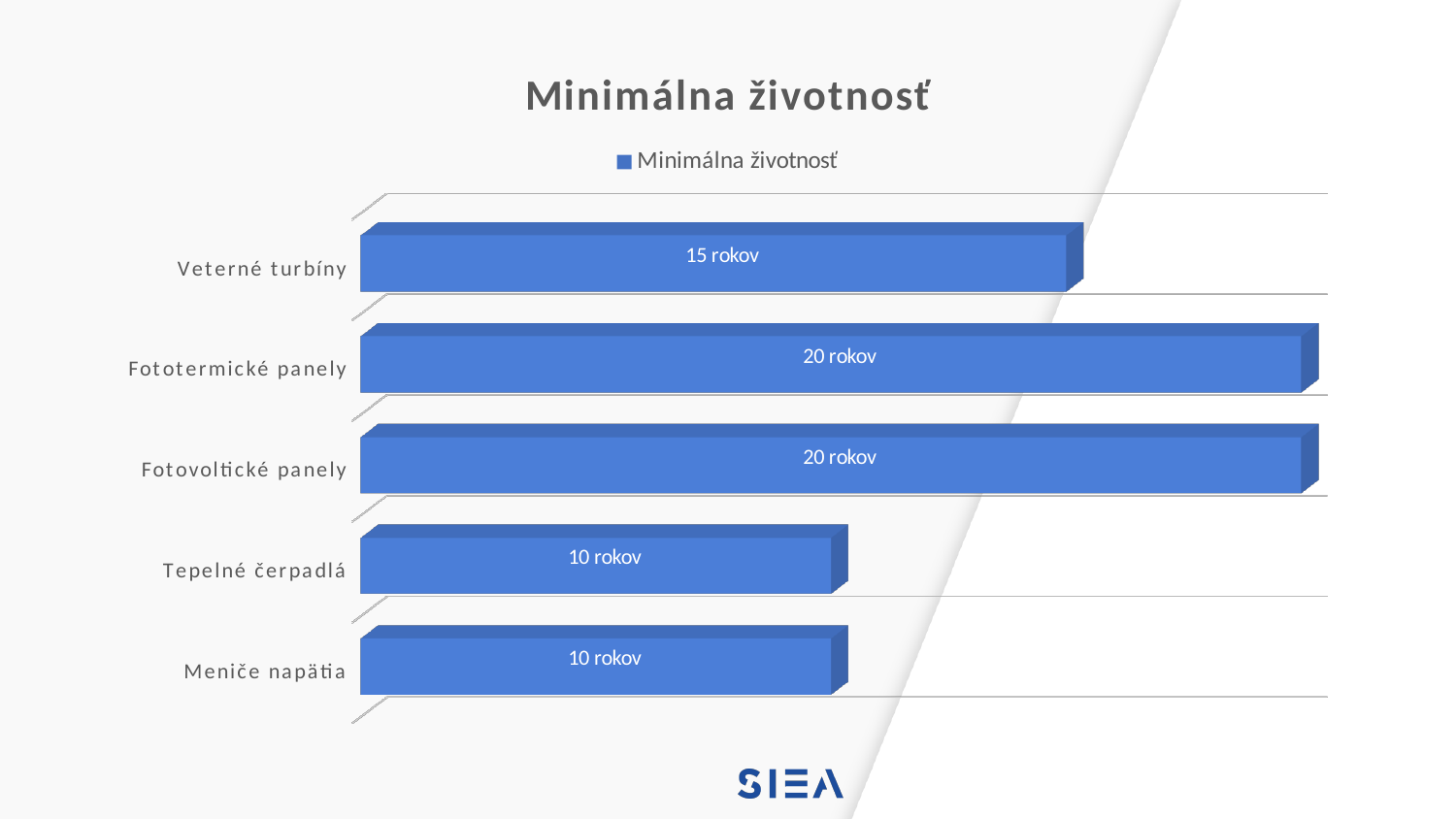
What is the difference between the values for Veterné turbíny and Tepelné čerpadlá? 5 rokov What is the minimum lifetime shown for Meniče napätia? 10 rokov What is the difference between the values for Fototermické panely and Veterné turbíny? 5 rokov What is the title of the chart? Minimálna životnosť What is the minimum lifetime shown for Veterné turbíny? 15 rokov What is the minimum lifetime shown for Fotovoltické panely? 20 rokov How many series does the legend list? 1 What is the minimum lifetime shown for Tepelné čerpadlá? 10 rokov How many categories are shown in the chart? 5 Which is larger, the value for Fototermické panely or the value for Veterné turbíny? Fototermické panely Which category has the lowest value, Veterné turbíny or Meniče napätia? Meniče napätia What kind of chart is shown on the slide? Bar chart